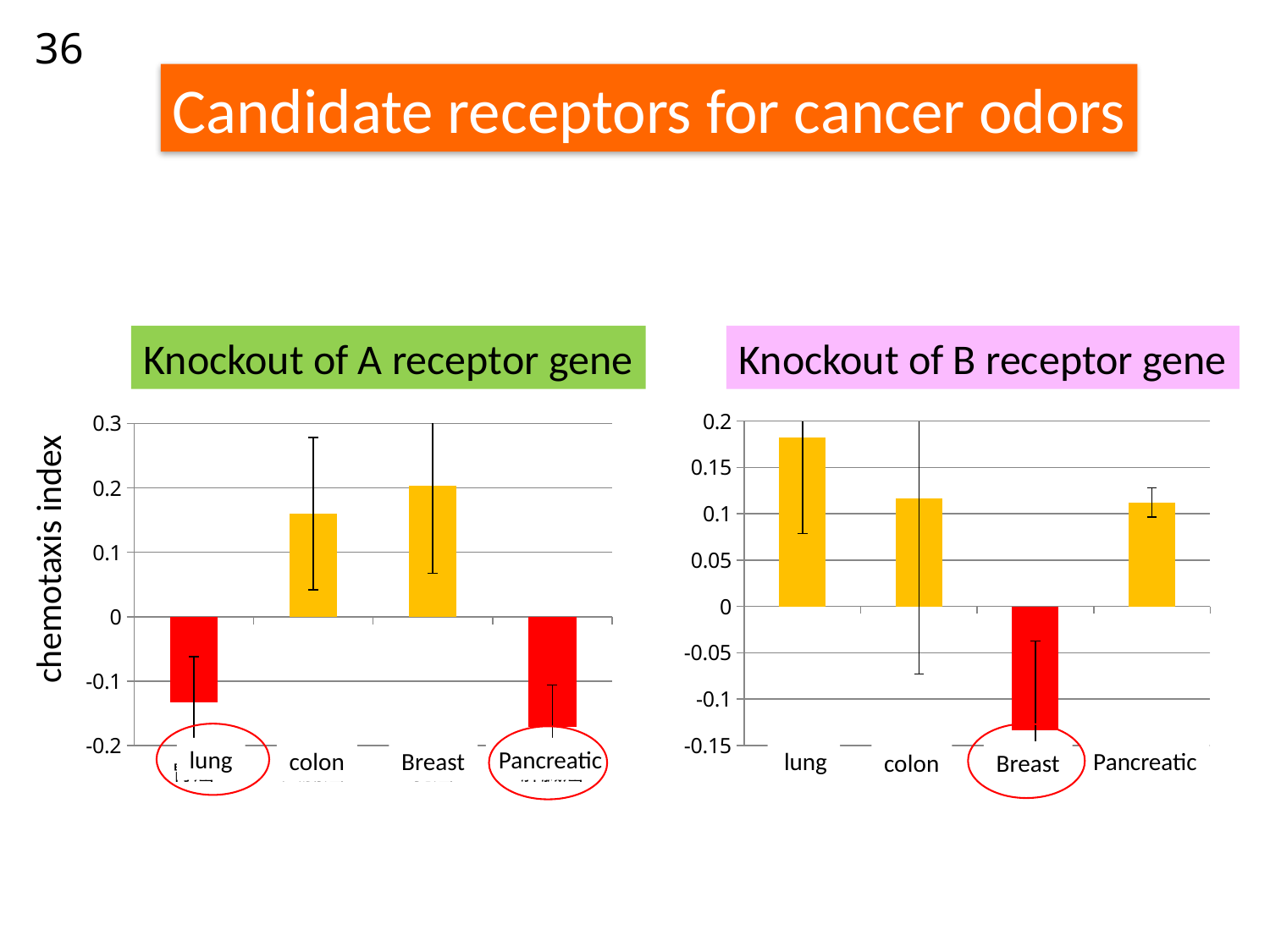
What is the label on the vertical axis of the left chart? chemotaxis index On the 'Knockout of A receptor gene' chart, is the value for colon greater or less than 0.1? greater On the 'Knockout of B receptor gene' chart, which category has the lowest value? Breast What kind of chart is the 'Knockout of A receptor gene' chart? bar chart On the 'Knockout of A receptor gene' chart, which is larger, the value for colon or the value for lung? colon On the 'Knockout of B receptor gene' chart, which category has the highest value? lung On the 'Knockout of B receptor gene' chart, is the value for Breast greater or less than -0.1? less How many categories are shown on the 'Knockout of B receptor gene' chart? 4 On the 'Knockout of A receptor gene' chart, which category has the lowest value? Pancreatic On the 'Knockout of A receptor gene' chart, which category has the highest value? Breast On the 'Knockout of B receptor gene' chart, is the value for lung greater or less than 0.15? greater